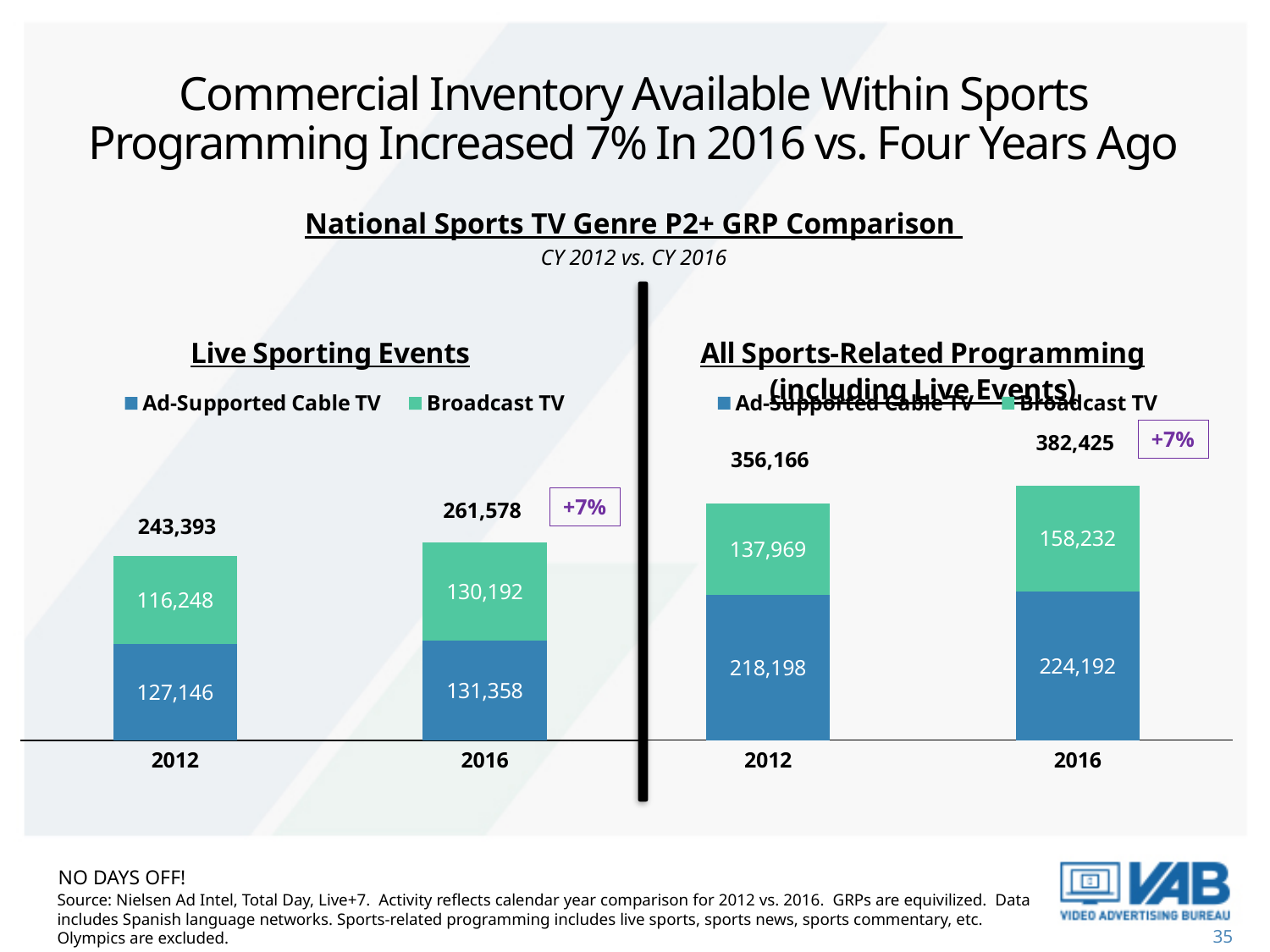
In the All Sports-Related Programming chart, which is larger in 2016: Ad-Supported Cable TV or Broadcast TV? Ad-Supported Cable TV In the All Sports-Related Programming chart, what is the Ad-Supported Cable TV value for 2016? 224,192 In the All Sports-Related Programming chart, what is the total of the stacked bar for 2012? 356,166 How many series does the legend of the Live Sporting Events chart list? 2 In the All Sports-Related Programming chart, what is the difference between the Ad-Supported Cable TV values for 2016 and 2012? 5,994 In the Live Sporting Events chart, what is the total of the stacked bar for 2016? 261,578 In the Live Sporting Events chart, what is the difference between the Broadcast TV values for 2016 and 2012? 13,944 In the All Sports-Related Programming chart, does the total rise or fall from 2012 to 2016? Rise In the Live Sporting Events chart, what is the Broadcast TV value for 2016? 130,192 In the All Sports-Related Programming chart, what is the Broadcast TV value for 2012? 137,969 In the Live Sporting Events chart, what is the Ad-Supported Cable TV value for 2012? 127,146 What kind of chart is the Live Sporting Events chart? Stacked bar chart